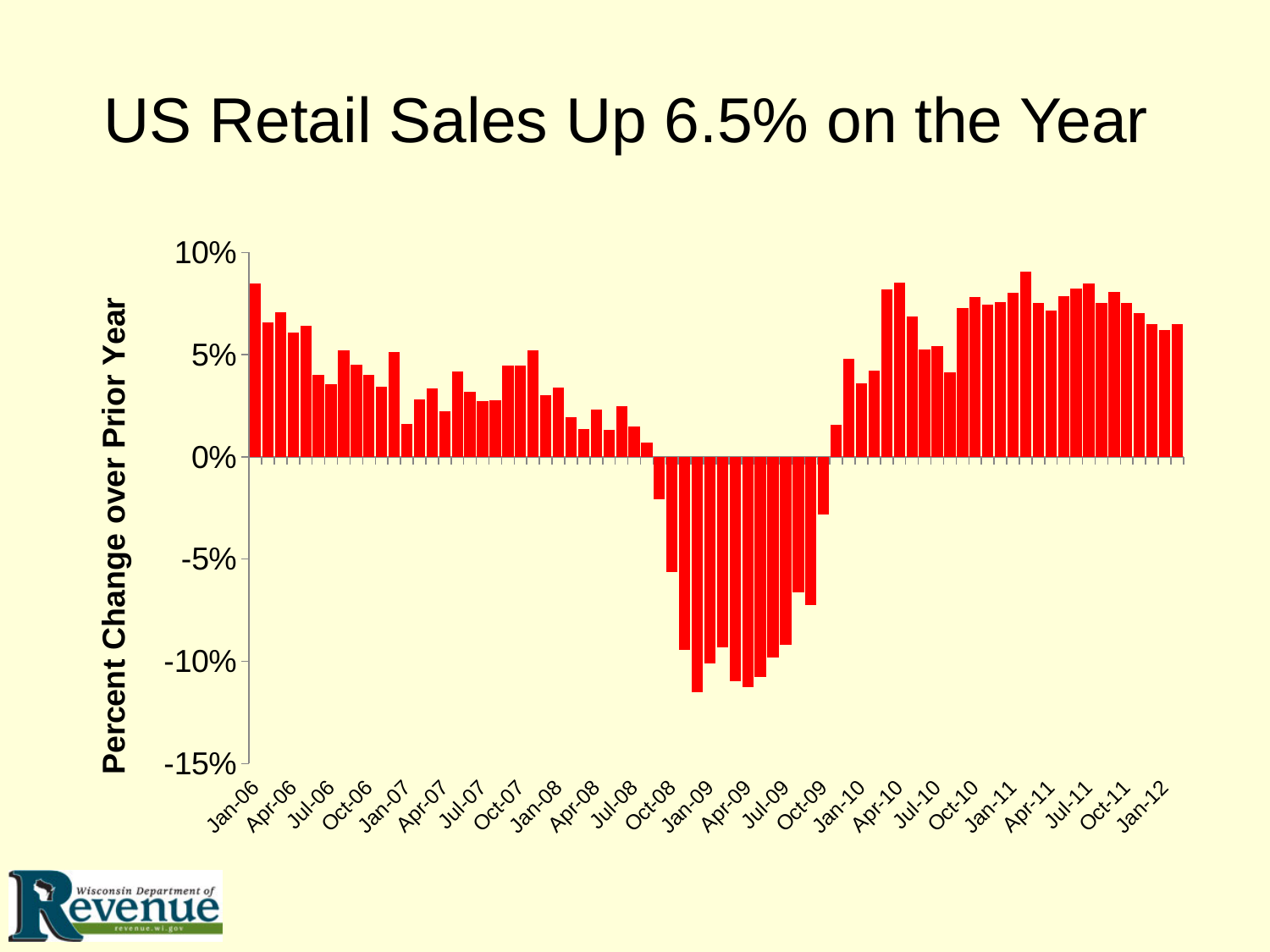
Is the value for Oct-09 greater or less than 0%? less Is the value for Apr-09 greater or less than -10%? less What kind of chart is shown on the slide? bar chart Which is larger, the value for Jan-06 or the value for Jan-09? Jan-06 Is the value for Jan-09 greater or less than -5%? less Which is larger, the value for Apr-09 or the value for Apr-10? Apr-10 What is the title of the chart on the slide? US Retail Sales Up 6.5% on the Year Do the values generally rise or fall from Jan-09 to Apr-10? rise What is the label on the vertical axis of the chart? Percent Change over Prior Year